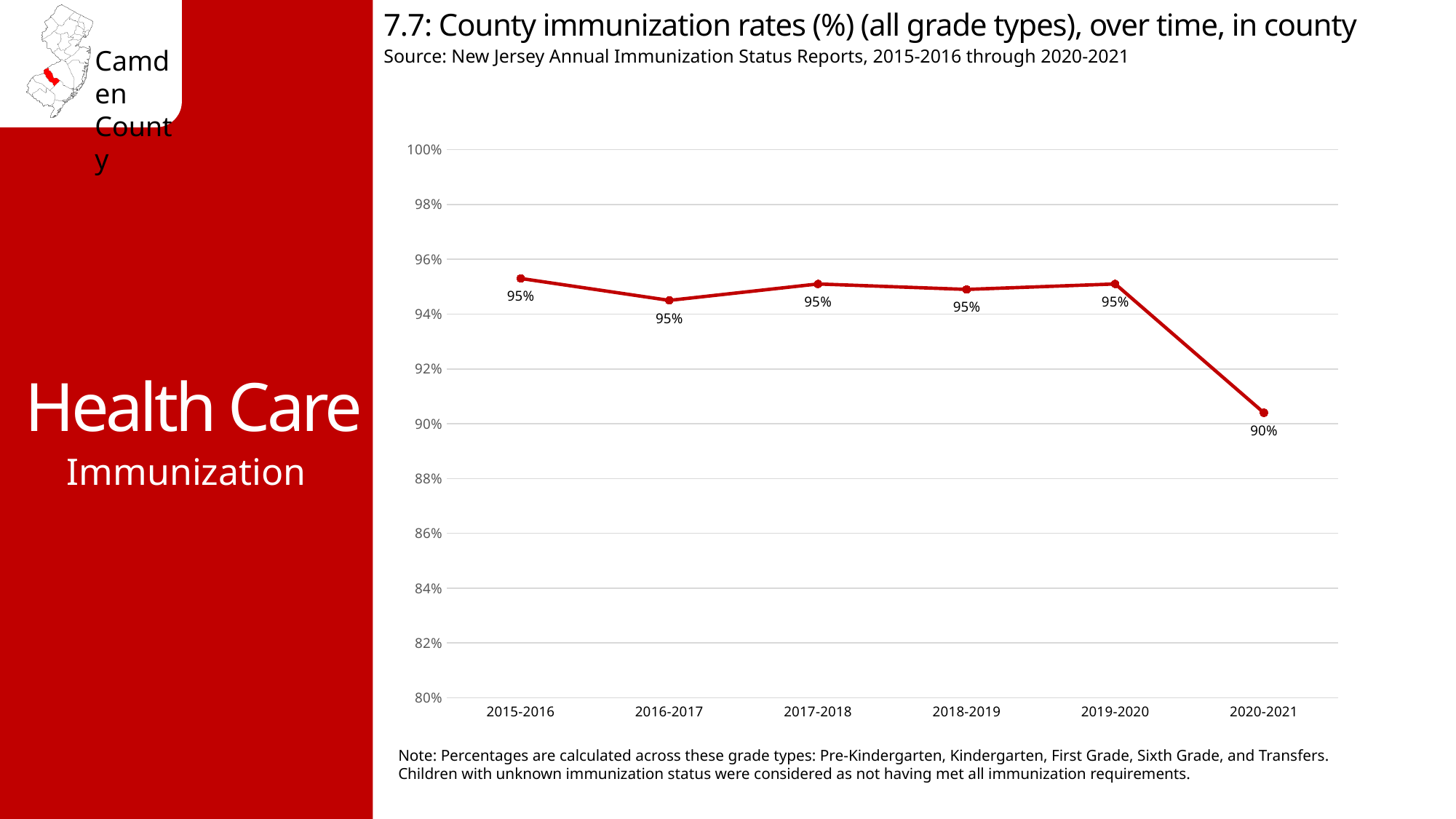
What is the county immunization rate for 2020-2021? 90% What is the county immunization rate for 2015-2016? 95% What kind of chart is shown on the slide? Line chart How many school years are plotted on the chart? 6 Is the immunization rate for 2020-2021 greater or less than 92%? less Does the immunization rate rise or fall between 2019-2020 and 2020-2021? Fall Which is larger, the immunization rate for 2017-2018 or for 2020-2021? 2017-2018 What is the source cited for the chart data? New Jersey Annual Immunization Status Reports, 2015-2016 through 2020-2021 Is the immunization rate for 2016-2017 greater or less than 94%? greater What is the county immunization rate for 2018-2019? 95% Which school year has the lowest county immunization rate? 2020-2021 What is the difference between the immunization rate in 2019-2020 and in 2020-2021? 5 percentage points